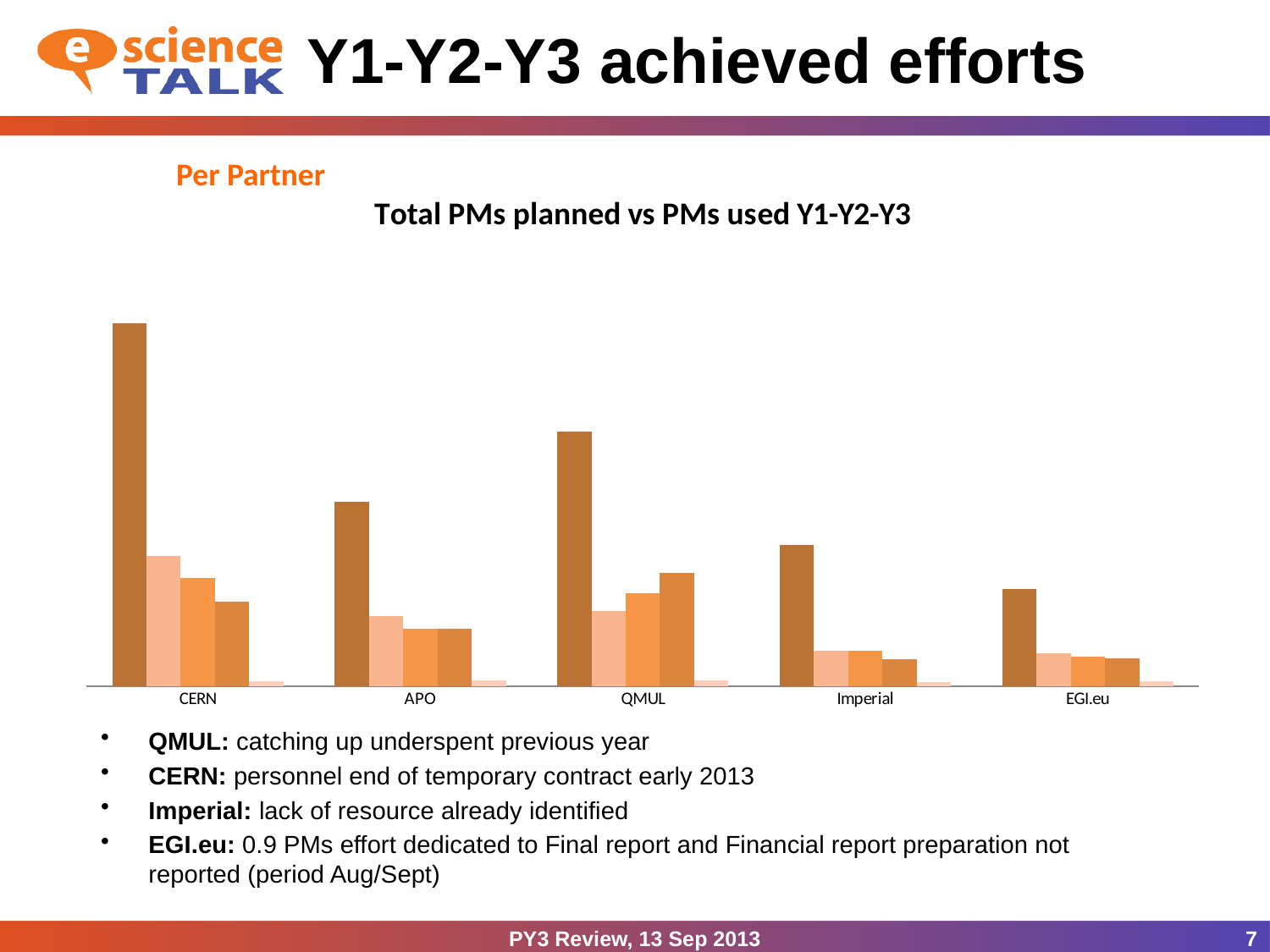
Within the CERN group, is the second bar or the fourth bar taller? second bar What kind of chart is shown on the slide? bar chart Which partner categories are listed on the x axis of the chart? CERN, APO, QMUL, Imperial, EGI.eu How many bars are plotted for each partner in the chart? 5 Within the QMUL group, is the second bar or the fourth bar taller? fourth bar Is the first (dark brown) bar taller for Imperial or for EGI.eu? Imperial Which partner has the tallest bar in the chart? CERN How many partner categories are shown on the x axis of the chart? 5 What is the title of the chart? Total PMs planned vs PMs used Y1-Y2-Y3 Which partner has the shortest first (dark brown) bar in the chart? EGI.eu